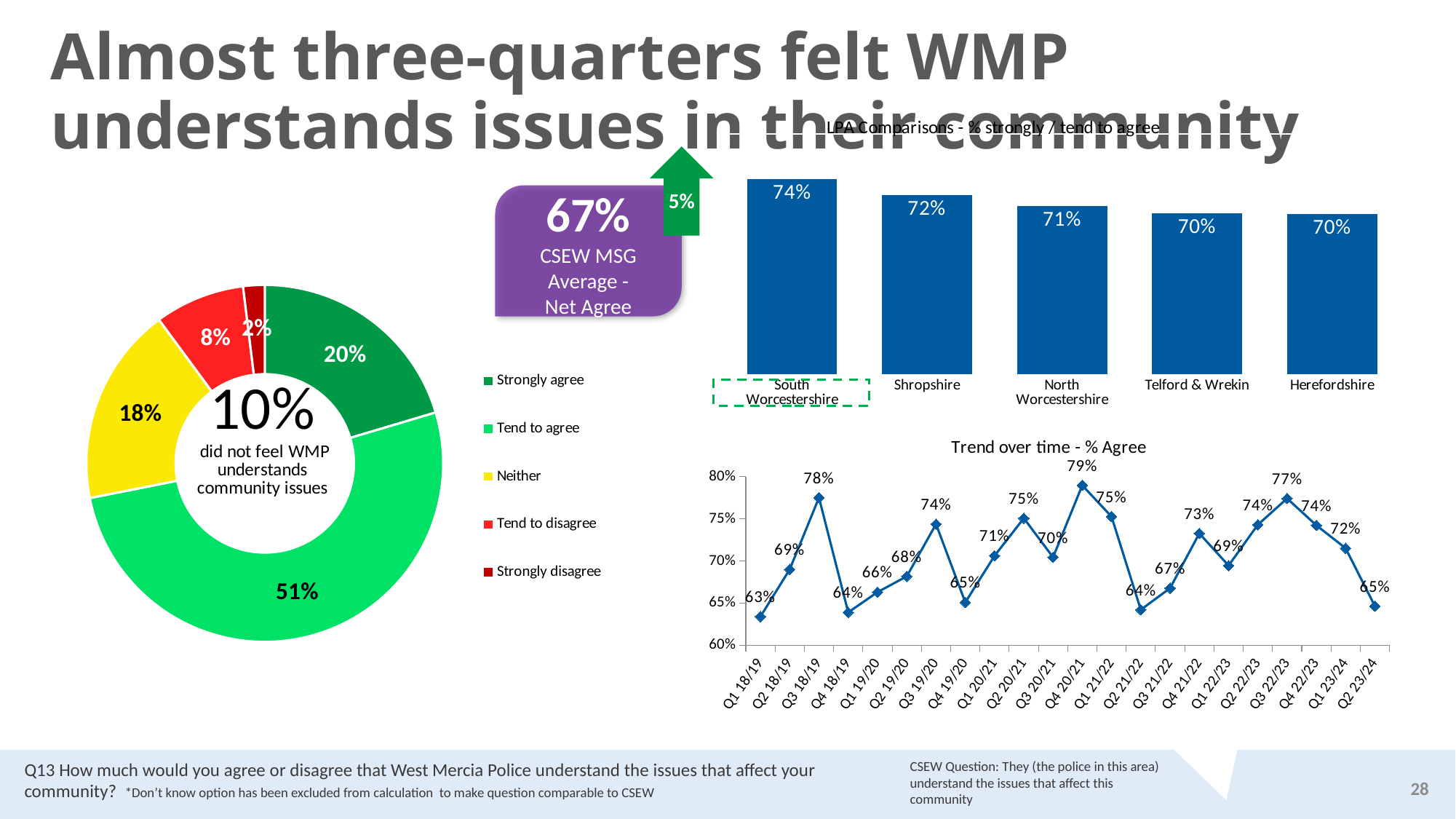
In the donut chart on the left, what is the combined share of 'Strongly agree' and 'Tend to agree'? 71% In the donut chart on the left, which response category has the smallest share? Strongly disagree How many entries does the legend of the donut chart on the left list? 5 In the 'Trend over time - % Agree' chart, what is the value for Q4 20/21? 79% In the 'Trend over time - % Agree' chart, is the value for Q3 22/23 larger or smaller than the value for Q2 23/24? Larger In the 'Trend over time - % Agree' chart, which quarter has the lowest value? Q1 18/19 In the donut chart on the left, what percentage of respondents said they 'Tend to agree'? 51% In the 'LPA Comparisons - % strongly / tend to agree' chart, what is the value for Shropshire? 72% In the 'LPA Comparisons - % strongly / tend to agree' chart, which LPA has the highest value? South Worcestershire What type of chart is the 'LPA Comparisons - % strongly / tend to agree' chart? Bar chart In the 'LPA Comparisons - % strongly / tend to agree' chart, what is the difference between South Worcestershire and Herefordshire? 4 percentage points How many data points are plotted in the 'Trend over time - % Agree' chart? 22